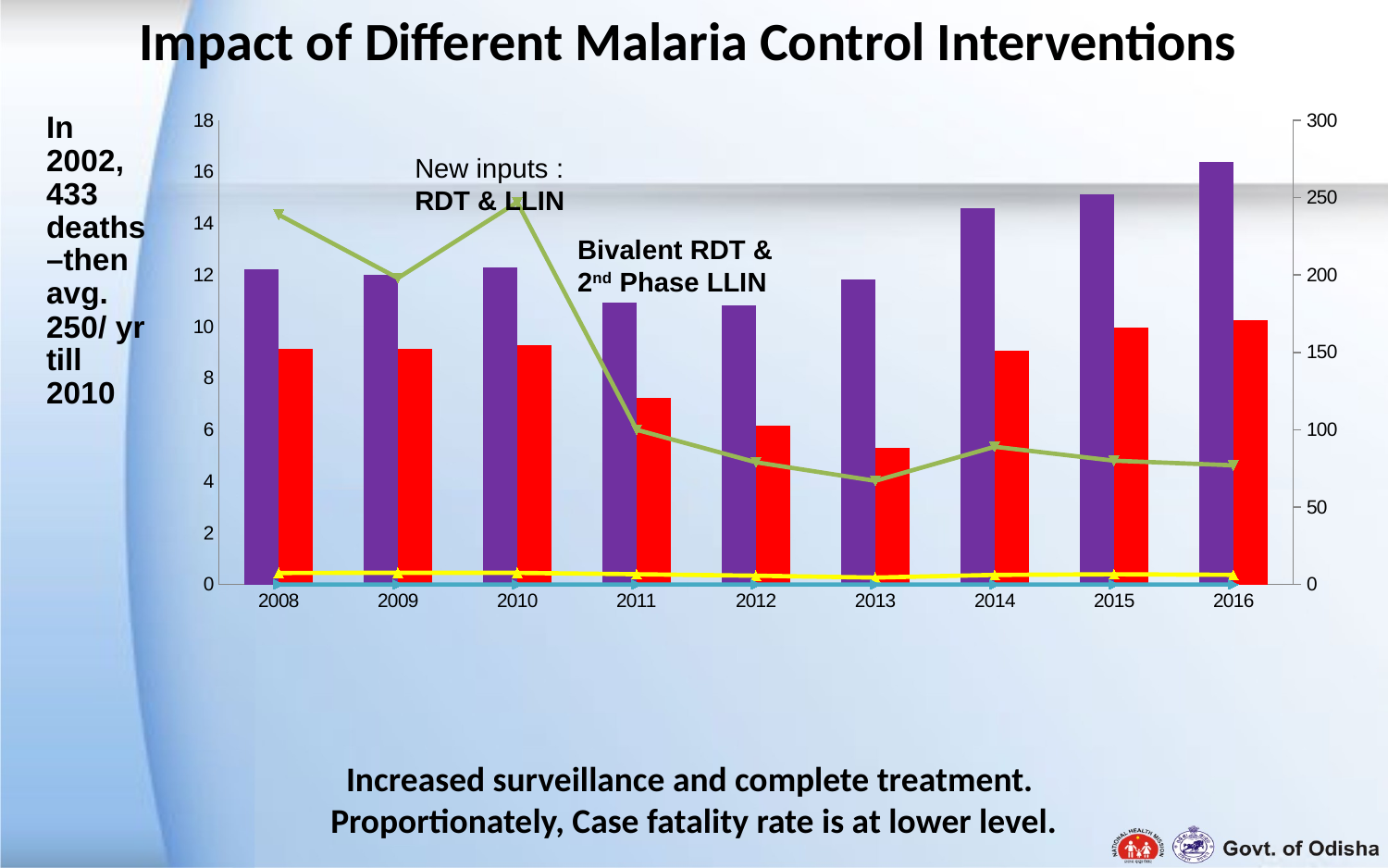
Is the purple bar for 2016 greater or less than 14 on the left axis? greater What kind of chart is shown on the slide? A combination bar and line chart In which year does the green line reach its lowest point? 2013 Is the red bar for 2013 greater or less than 6 on the left axis? less How many years are shown on the x axis of the chart? 9 Is the green line value for 2011 greater or less than 150 on the right axis? less In which year is the red bar the shortest? 2013 In which year is the purple bar the tallest? 2016 Which is taller, the purple bar for 2008 or the purple bar for 2016? 2016 Does the green line overall rise or fall from 2008 to 2016? fall What is the title of the chart on the slide? Impact of Different Malaria Control Interventions